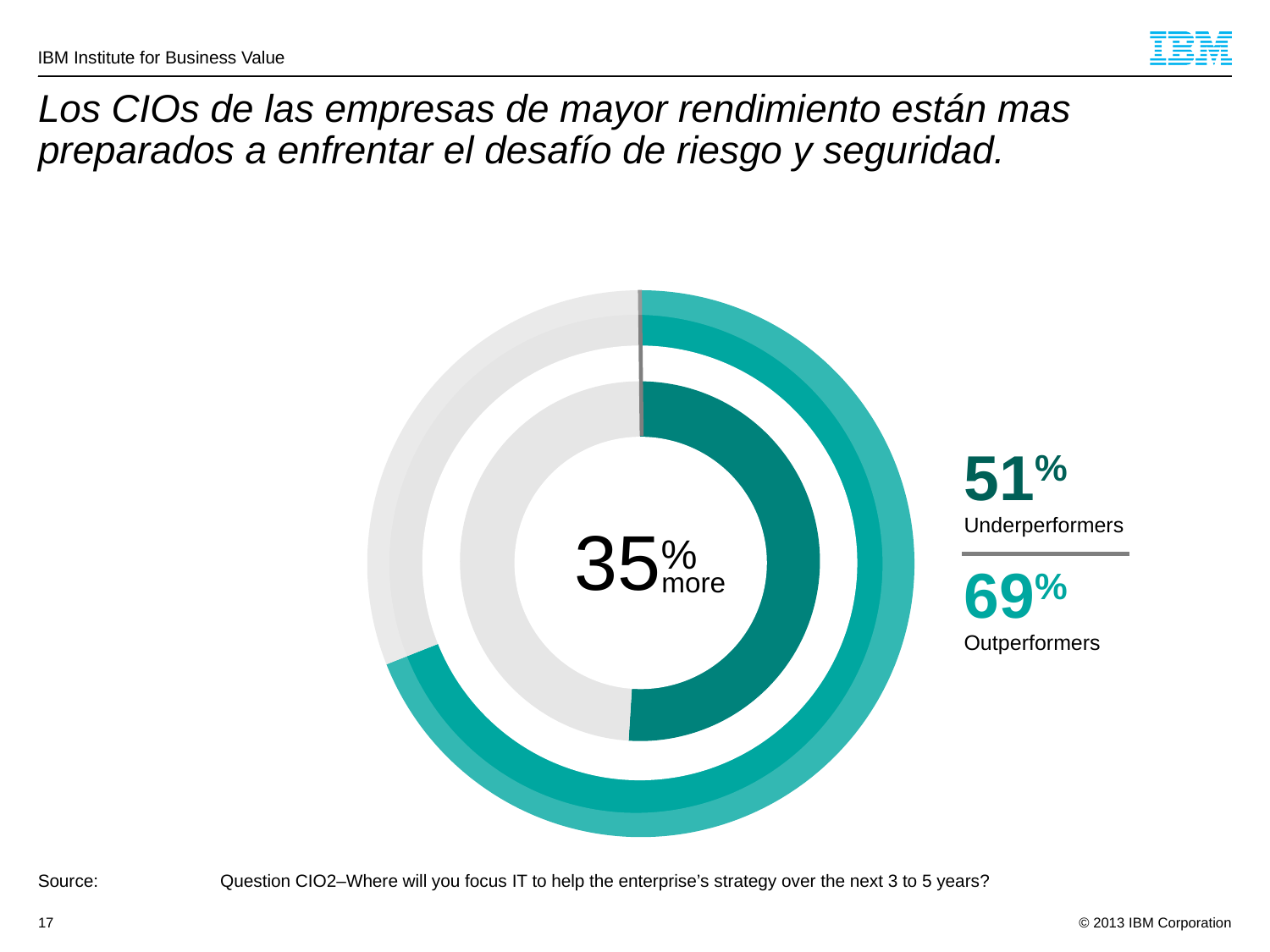
Is the value for Outperformers greater or less than 50%? greater What kind of chart is shown on the slide? Donut chart How many groups are shown in the chart? 2 What percentage is shown for Underperformers? 51% What colour is the inner ring segment representing Underperformers? Dark teal Which group has the lowest percentage shown? Underperformers Which ring of the chart, inner or outer, represents Outperformers? Outer Which group has the higher percentage, Underperformers or Outperformers? Outperformers Which group has the highest percentage shown? Outperformers What value is printed in the centre of the chart? 35% more What is the difference in percentage points between Outperformers and Underperformers? 18 What percentage is shown for Outperformers? 69%